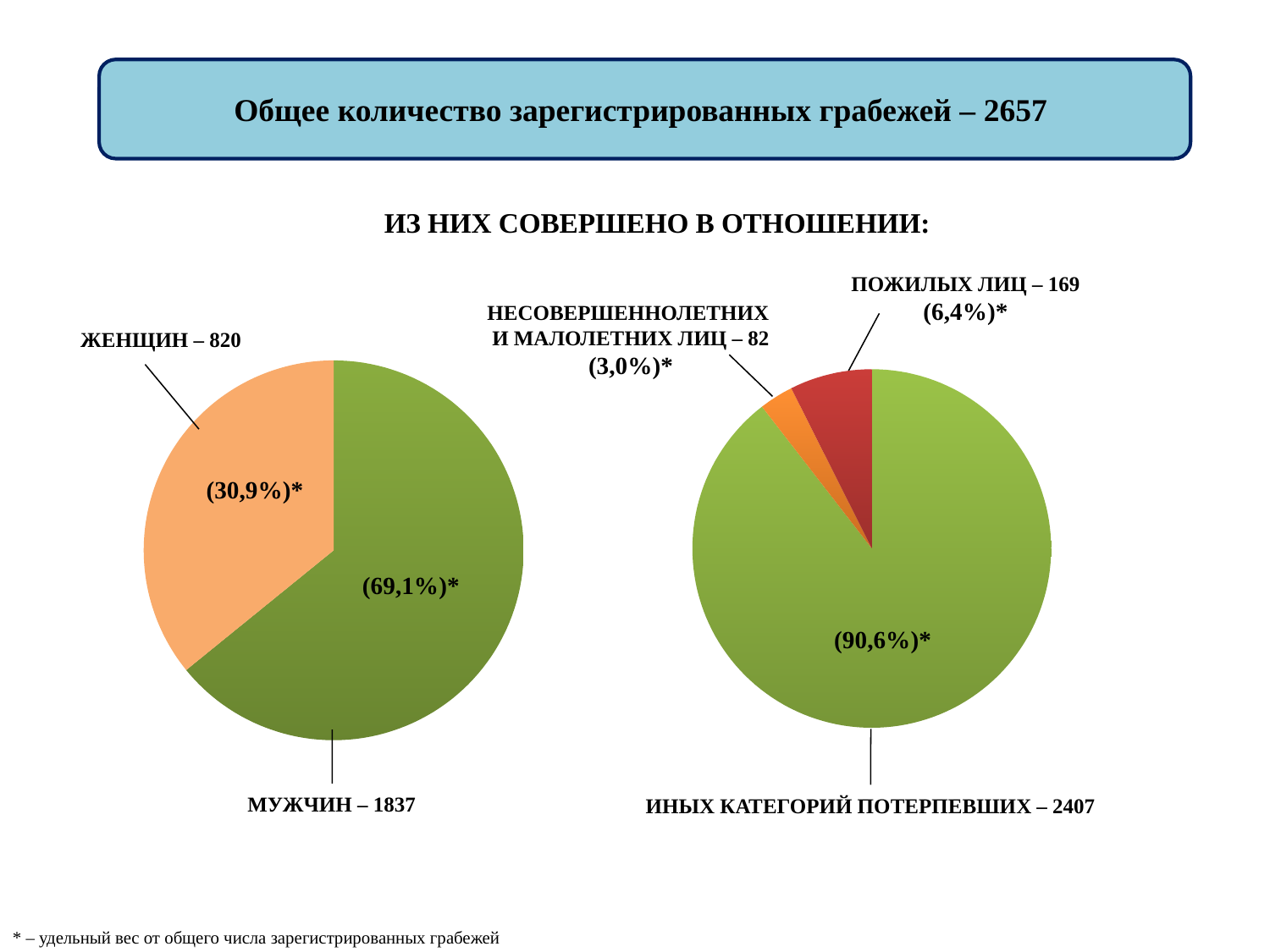
In the left pie chart, what is the value for ЖЕНЩИН? 820 In the right pie chart, what is the value for НЕСОВЕРШЕННОЛЕТНИХ И МАЛОЛЕТНИХ ЛИЦ? 82 In the right pie chart, what is the value for ПОЖИЛЫХ ЛИЦ? 169 In the right pie chart, which category is the smallest? НЕСОВЕРШЕННОЛЕТНИХ И МАЛОЛЕТНИХ ЛИЦ In the right pie chart, what share of the pie does the ИНЫХ КАТЕГОРИЙ ПОТЕРПЕВШИХ slice represent? 90,6% In the left pie chart, what is the value for МУЖЧИН? 1837 In the right pie chart, which is larger: ПОЖИЛЫХ ЛИЦ or НЕСОВЕРШЕННОЛЕТНИХ И МАЛОЛЕТНИХ ЛИЦ? ПОЖИЛЫХ ЛИЦ How many slices does the right pie chart have? 3 What type of chart is the left chart on the slide? pie chart In the left pie chart, what share of the pie does the ЖЕНЩИН slice represent? 30,9% In the left pie chart, what is the difference between the values for МУЖЧИН and ЖЕНЩИН? 1017 In the left pie chart, which category is the largest? МУЖЧИН